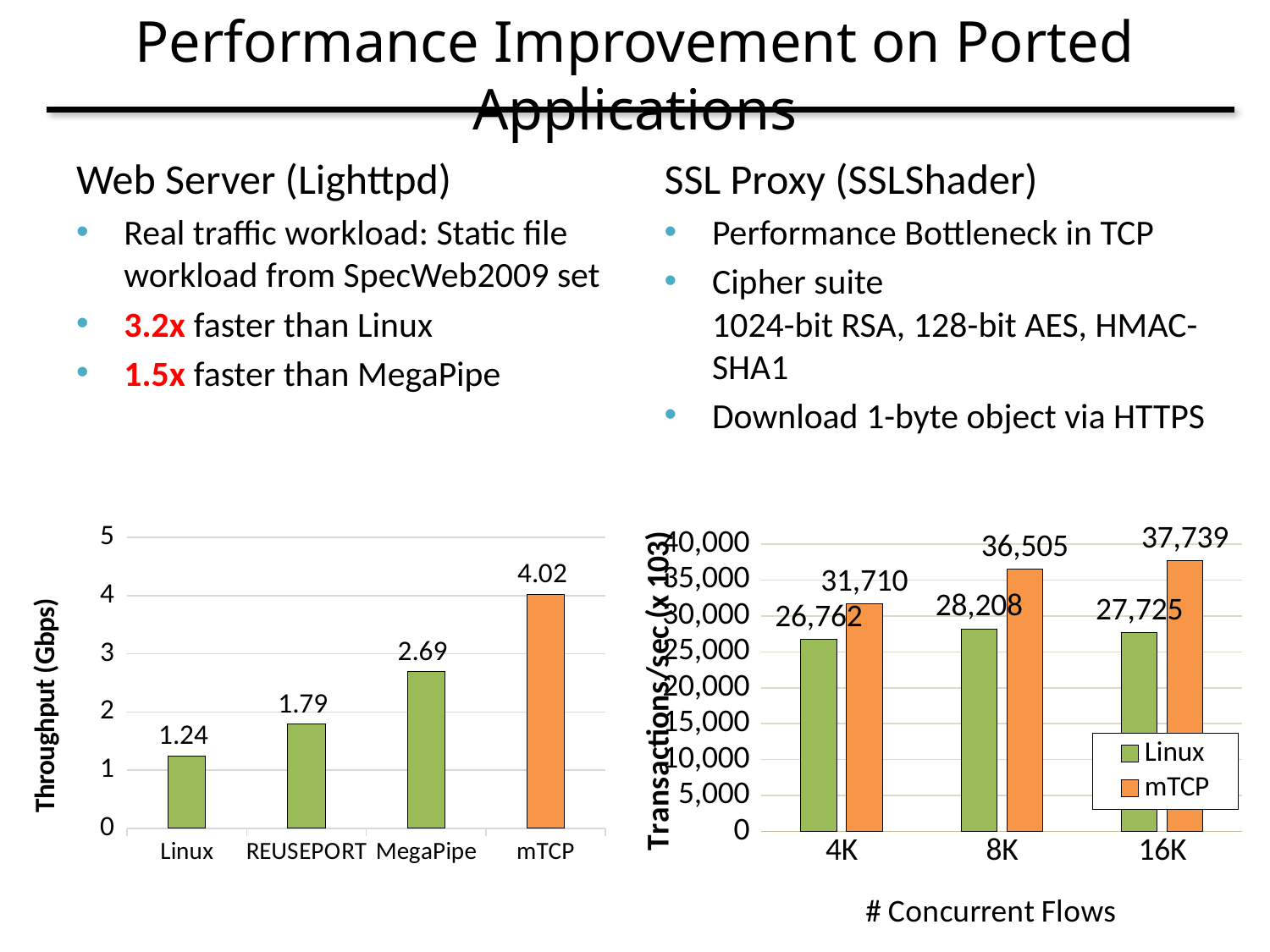
In the right chart (Transactions/sec), which series has the larger value at 16K concurrent flows, Linux or mTCP? mTCP In the left chart (Throughput), do the values rise or fall from Linux to mTCP along the x axis? rise In the left chart (Throughput), which category has the lowest throughput? Linux In the left chart (Throughput), what is the throughput for REUSEPORT? 1.79 In the left chart (Throughput), how many categories are shown on the x axis? 4 What kind of chart is the right chart (Transactions/sec)? bar chart In the right chart (Transactions/sec), what is the Linux value at 4K concurrent flows? 26,762 In the right chart (Transactions/sec), what is the mTCP value at 8K concurrent flows? 36,505 In the left chart (Throughput), what is the difference in throughput between mTCP and MegaPipe? 1.33 In the left chart (Throughput), what is the throughput for mTCP? 4.02 In the right chart (Transactions/sec), how many series does the legend list? 2 In the right chart (Transactions/sec), what is the difference between mTCP and Linux at 16K concurrent flows? 10,014